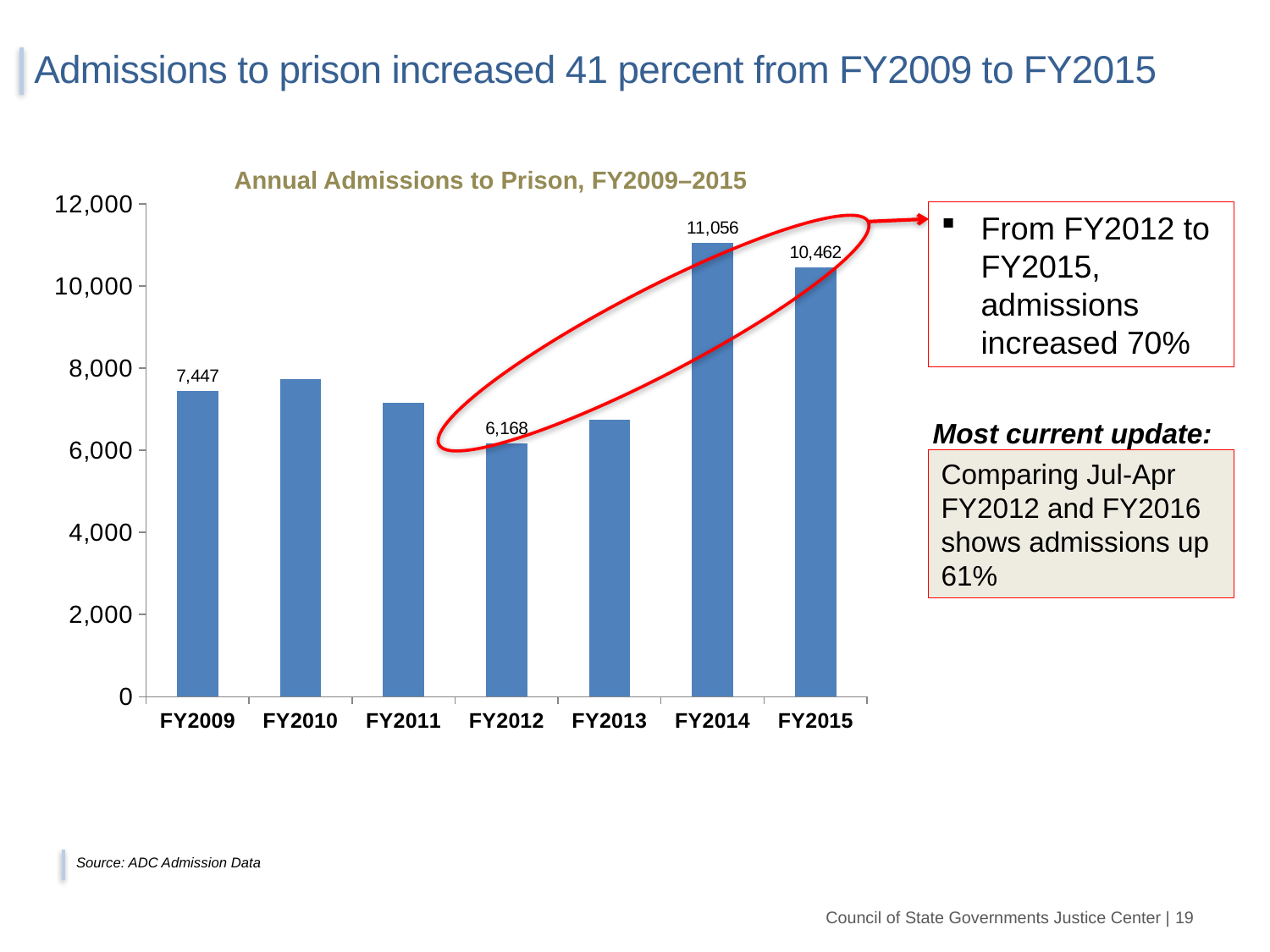
What is the value for FY2012? 6,168 What is the difference between the FY2015 and FY2012 values? 4,294 What is the value for FY2015? 10,462 What type of chart is shown? bar chart What is the value for FY2014? 11,056 Which fiscal year has the lowest admissions? FY2012 Which fiscal year has the highest admissions? FY2014 What is the value for FY2009? 7,447 Which is larger, the value for FY2010 or the value for FY2013? FY2010 How many fiscal years are shown on the x axis? 7 Is the value for FY2011 greater or less than 8,000? less What is the difference between the FY2014 and FY2015 values? 594